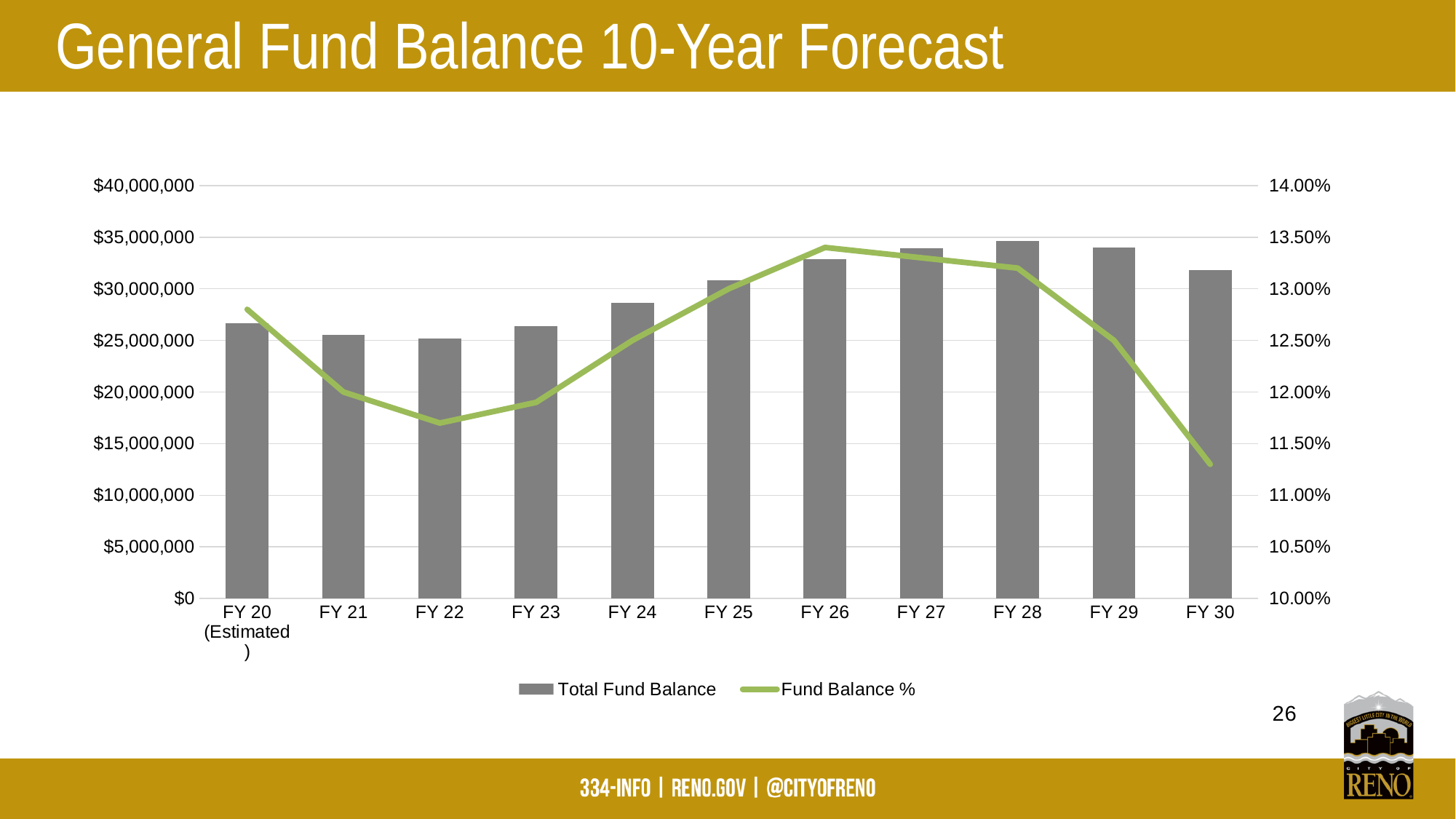
In which fiscal year does the Fund Balance % line reach its lowest point? FY 30 What colour is the Fund Balance % line? Green What kind of chart is shown on the slide? A combined bar and line chart Is the Total Fund Balance for FY 22 greater or less than $30,000,000? less Is the Total Fund Balance for FY 25 greater or less than $30,000,000? greater How many series does the legend list? 2 Does the Fund Balance % line rise or fall from FY 26 to FY 30? It falls Which fiscal year has the highest Total Fund Balance bar? FY 28 Is the Fund Balance % for FY 30 greater or less than 11.50%? less In which fiscal year does the Fund Balance % line reach its highest point? FY 26 Which has the larger Total Fund Balance, FY 21 or FY 26? FY 26 How many fiscal years are shown on the x axis? 11